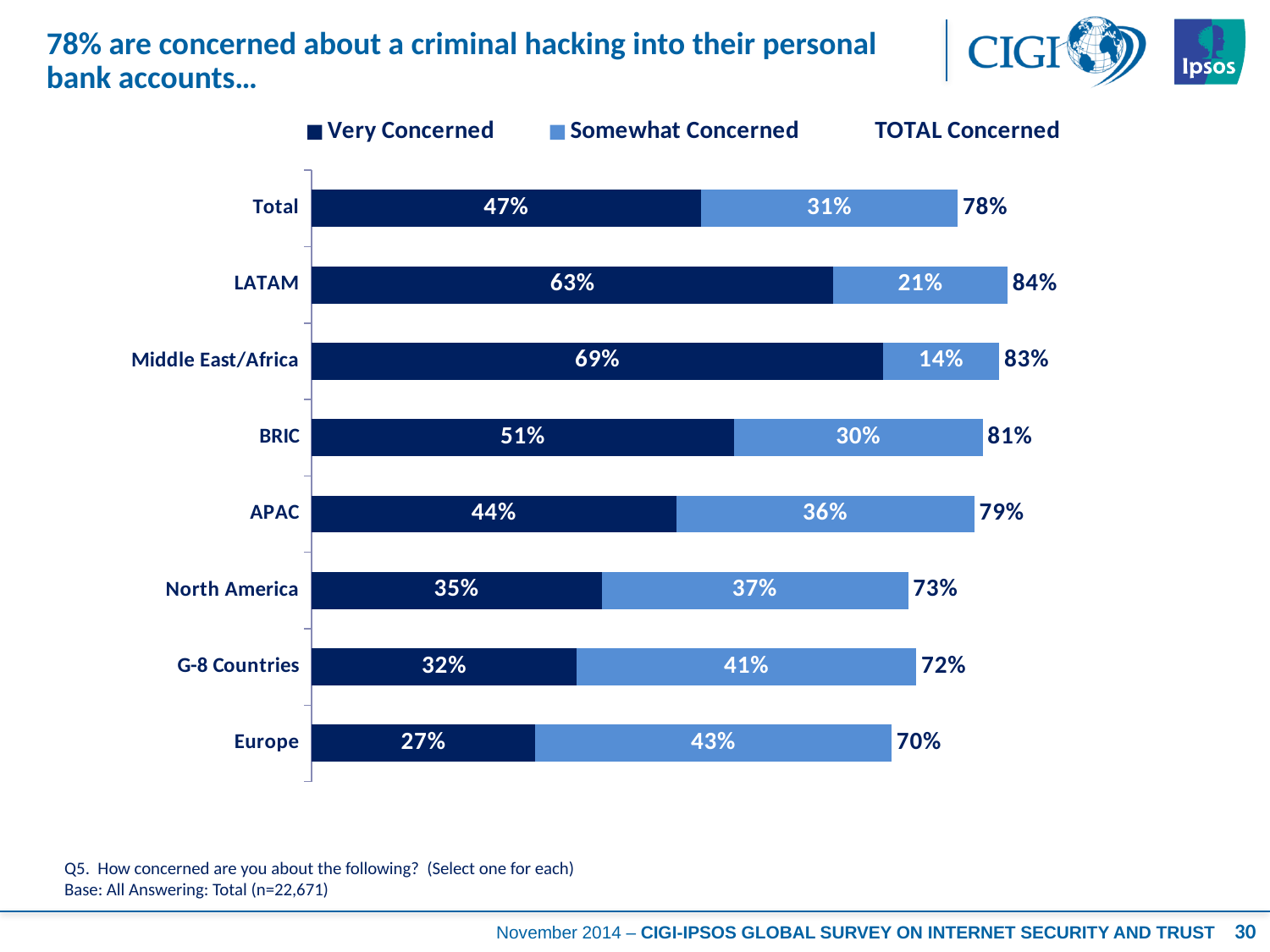
What is the difference between the Very Concerned values for BRIC and APAC? 7% Which has a larger Somewhat Concerned value, G-8 Countries or Middle East/Africa? G-8 Countries What percentage of respondents in LATAM are Very Concerned? 63% What is the Somewhat Concerned value for North America? 37% Which colour represents Very Concerned in the chart? Dark blue Which region has the lowest TOTAL Concerned percentage? Europe How many series does the legend list with a colour swatch? 2 What is the TOTAL Concerned value for Europe? 70% What is the total of the stacked bar for BRIC? 81% What kind of chart is shown on the slide? Stacked bar chart Which region has the highest Very Concerned percentage? Middle East/Africa How many categories (bars) are shown in the chart? 8